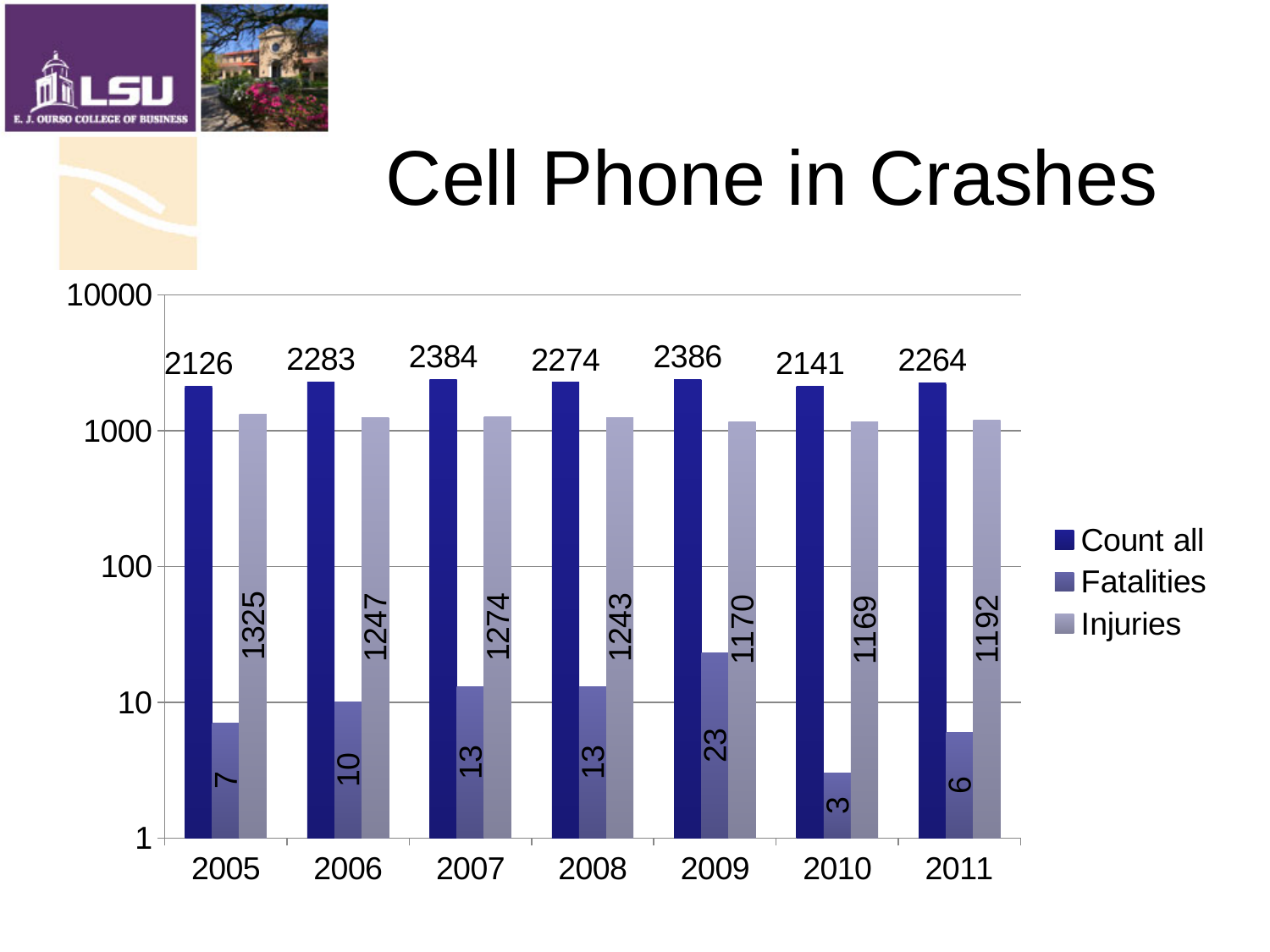
Which is larger, the Injuries value for 2006 or for 2011? 2006 Which year has the lowest Count all value? 2005 What kind of chart is shown on the slide? bar chart What is the Injuries value for 2005? 1325 What is the title of the chart? Cell Phone in Crashes Is the Fatalities value for 2009 greater or less than 10? greater How many years are shown on the x axis? 7 What is the difference between the Count all values for 2007 and 2010? 243 How many series does the legend list? 3 What is the Count all value for 2009? 2386 How many Fatalities are shown for 2010? 3 Which year has the highest Fatalities value? 2009